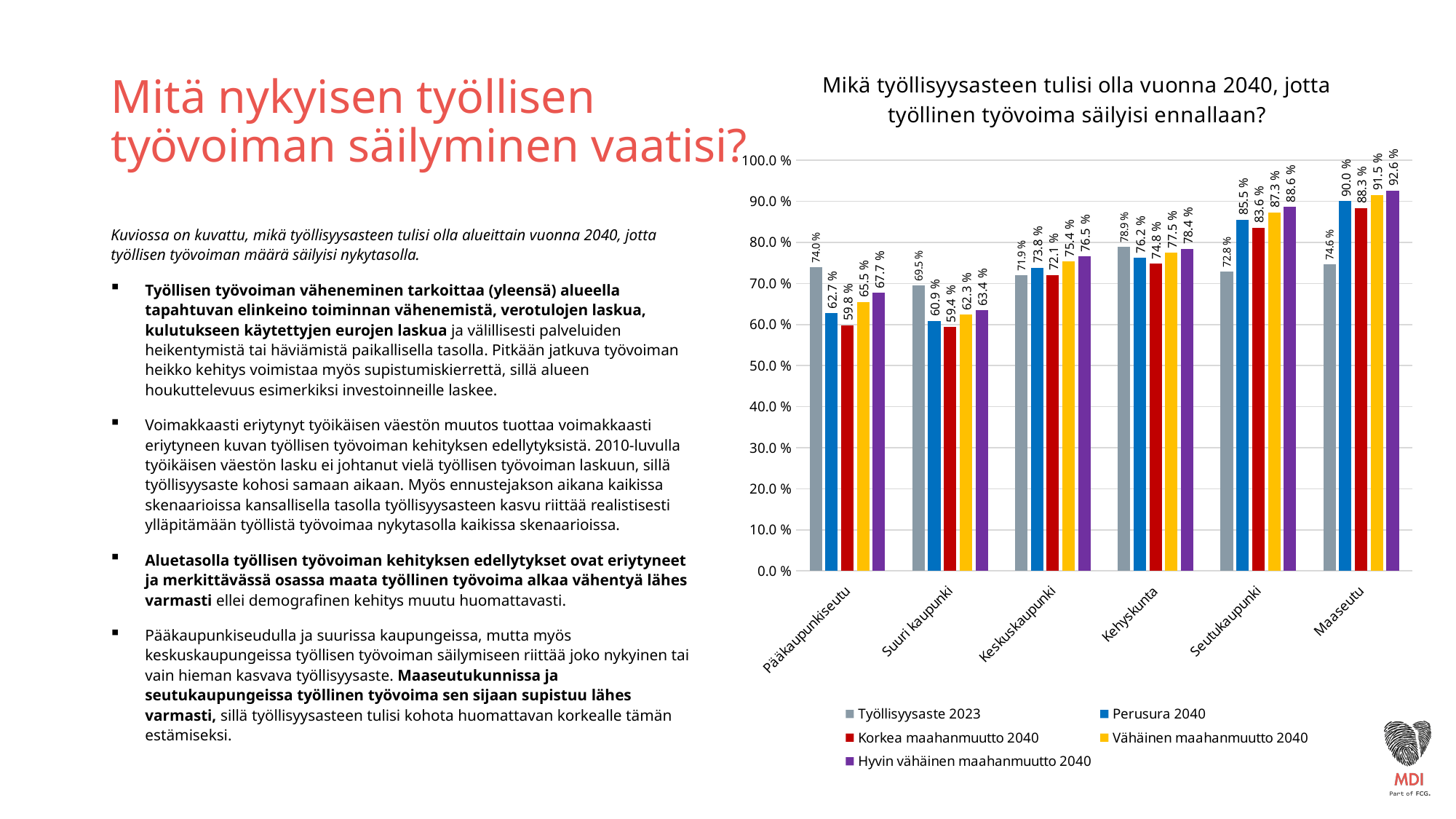
What kind of chart is shown on the slide? bar chart What is the value of Perusura 2040 for Maaseutu? 90.0 % What colour are the Korkea maahanmuutto 2040 bars? red What is the difference between the Vähäinen maahanmuutto 2040 value and the Työllisyysaste 2023 value for Seutukaupunki? 14.5 % What is the value of Korkea maahanmuutto 2040 for Suuri kaupunki? 59.4 % Which is larger for Kehyskunta: Työllisyysaste 2023 or Perusura 2040? Työllisyysaste 2023 Is the value of Hyvin vähäinen maahanmuutto 2040 for Maaseutu greater or less than 90.0 %? greater How many series does the legend list? 5 How many categories are shown on the x axis? 6 What is the value of Työllisyysaste 2023 for Pääkaupunkiseutu? 74.0 % Which category has the highest value for Hyvin vähäinen maahanmuutto 2040? Maaseutu Which category has the lowest value for Työllisyysaste 2023? Suuri kaupunki